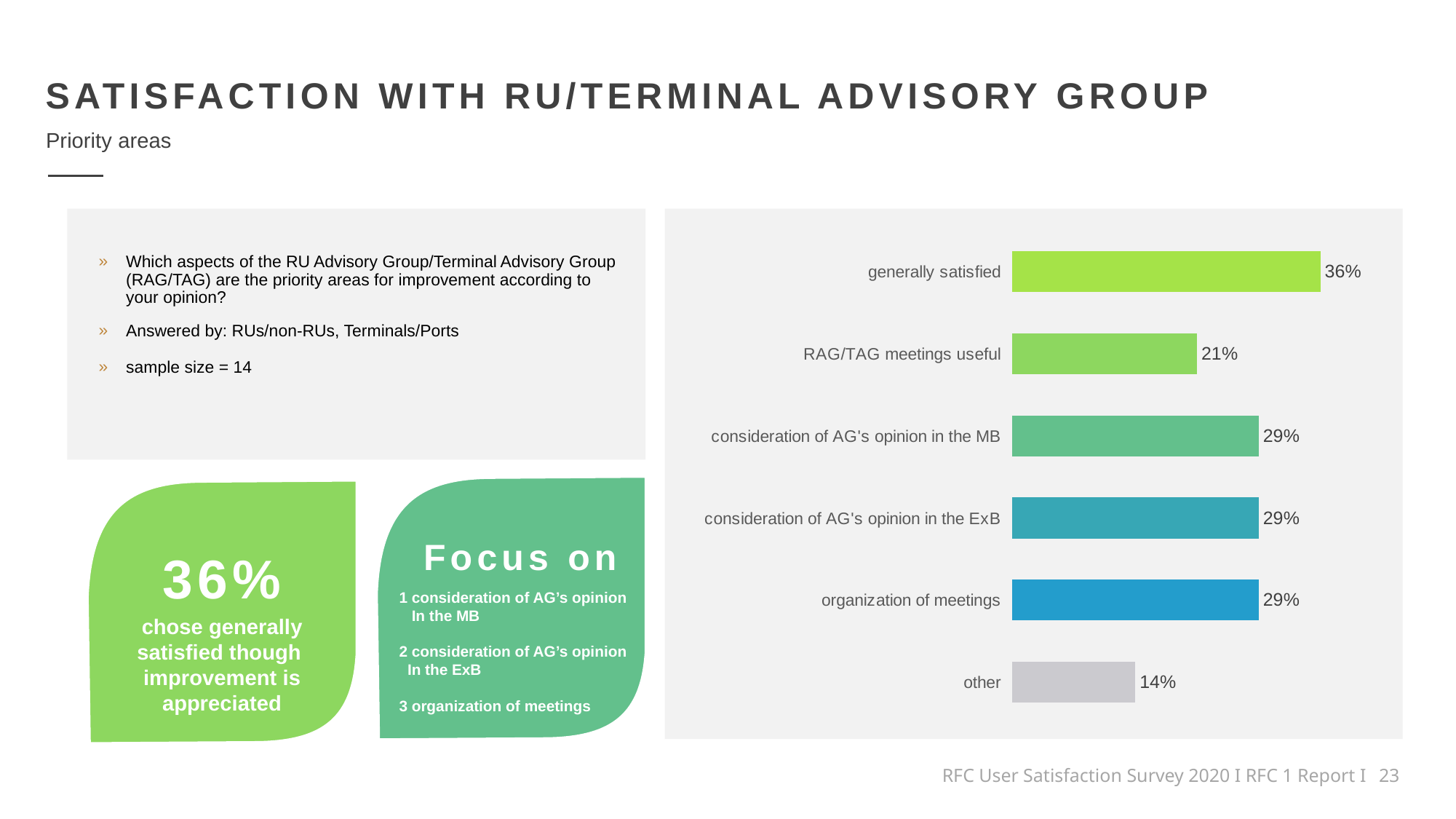
Which is larger: 'consideration of AG's opinion in the MB' or 'RAG/TAG meetings useful'? consideration of AG's opinion in the MB Which category has the highest value? generally satisfied What colour is the bar for 'other'? grey Which category has the lowest value? other What percentage is shown for 'generally satisfied'? 36% How many categories are shown in the chart? 6 What percentage is shown for 'other'? 14% How many categories share the value 29%? 3 What is the difference between 'generally satisfied' and 'RAG/TAG meetings useful'? 15% What is the value for 'organization of meetings'? 29% What kind of chart is shown on the slide? bar chart What is the value for 'RAG/TAG meetings useful'? 21%